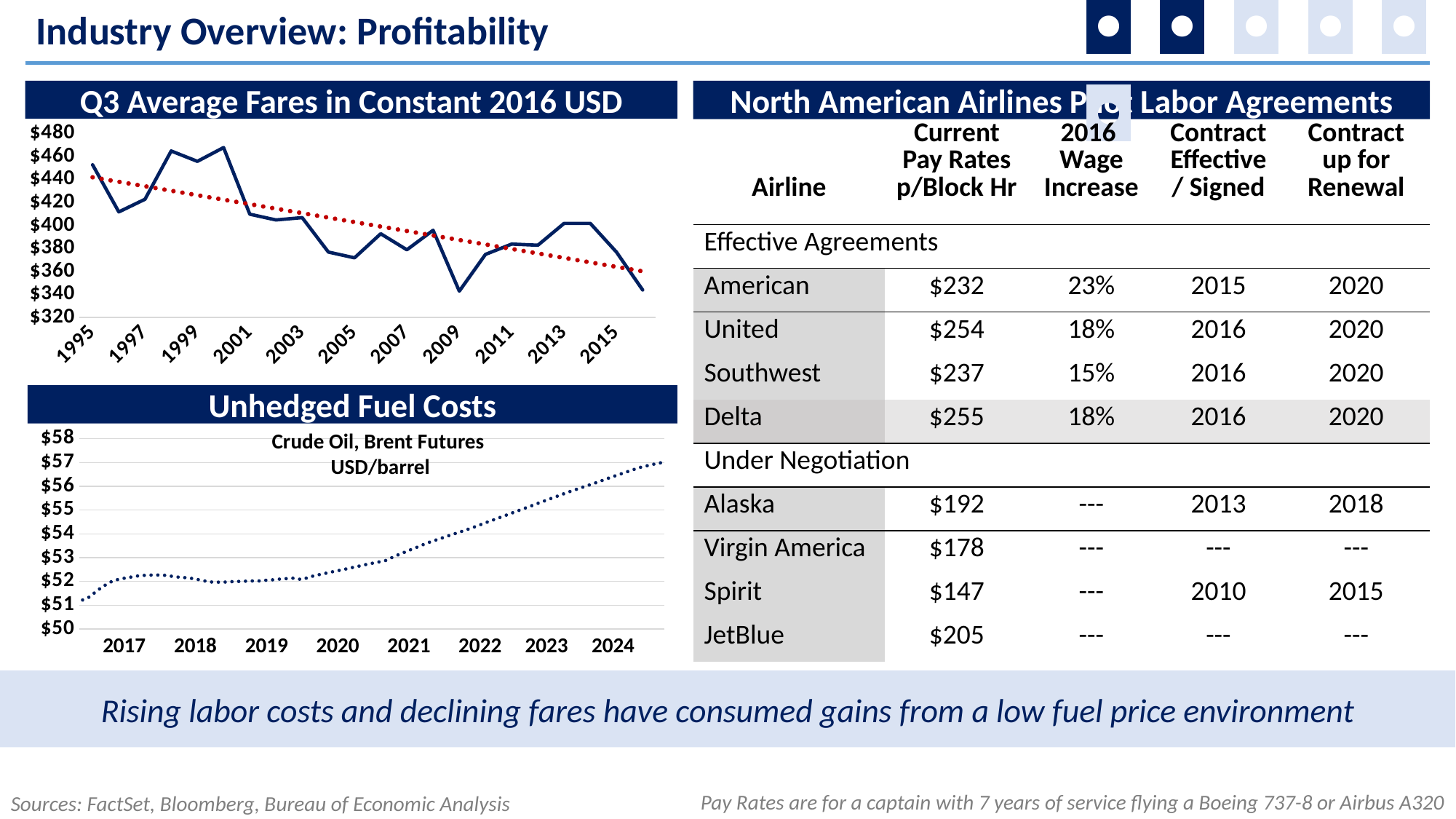
In the 'Q3 Average Fares in Constant 2016 USD' chart, is the value for 2009 greater or less than $360? less In the 'Q3 Average Fares in Constant 2016 USD' chart, do the fares generally rise or fall from 1995 to the end of the series? fall What kind of chart is the 'Unhedged Fuel Costs' chart? line chart In the 'Q3 Average Fares in Constant 2016 USD' chart, is the value for 2005 greater or less than $380? less In the 'Q3 Average Fares in Constant 2016 USD' chart, is the value for 1995 greater or less than $420? greater What subtitle is printed inside the 'Unhedged Fuel Costs' chart? Crude Oil, Brent Futures USD/barrel How many year labels are shown on the x axis of the 'Unhedged Fuel Costs' chart? 8 In the 'Unhedged Fuel Costs' chart, which year has the larger value, 2017 or 2024? 2024 In the 'Unhedged Fuel Costs' chart, do the values rise or fall from 2017 to 2024? rise What kind of chart is the 'Q3 Average Fares in Constant 2016 USD' chart? line chart